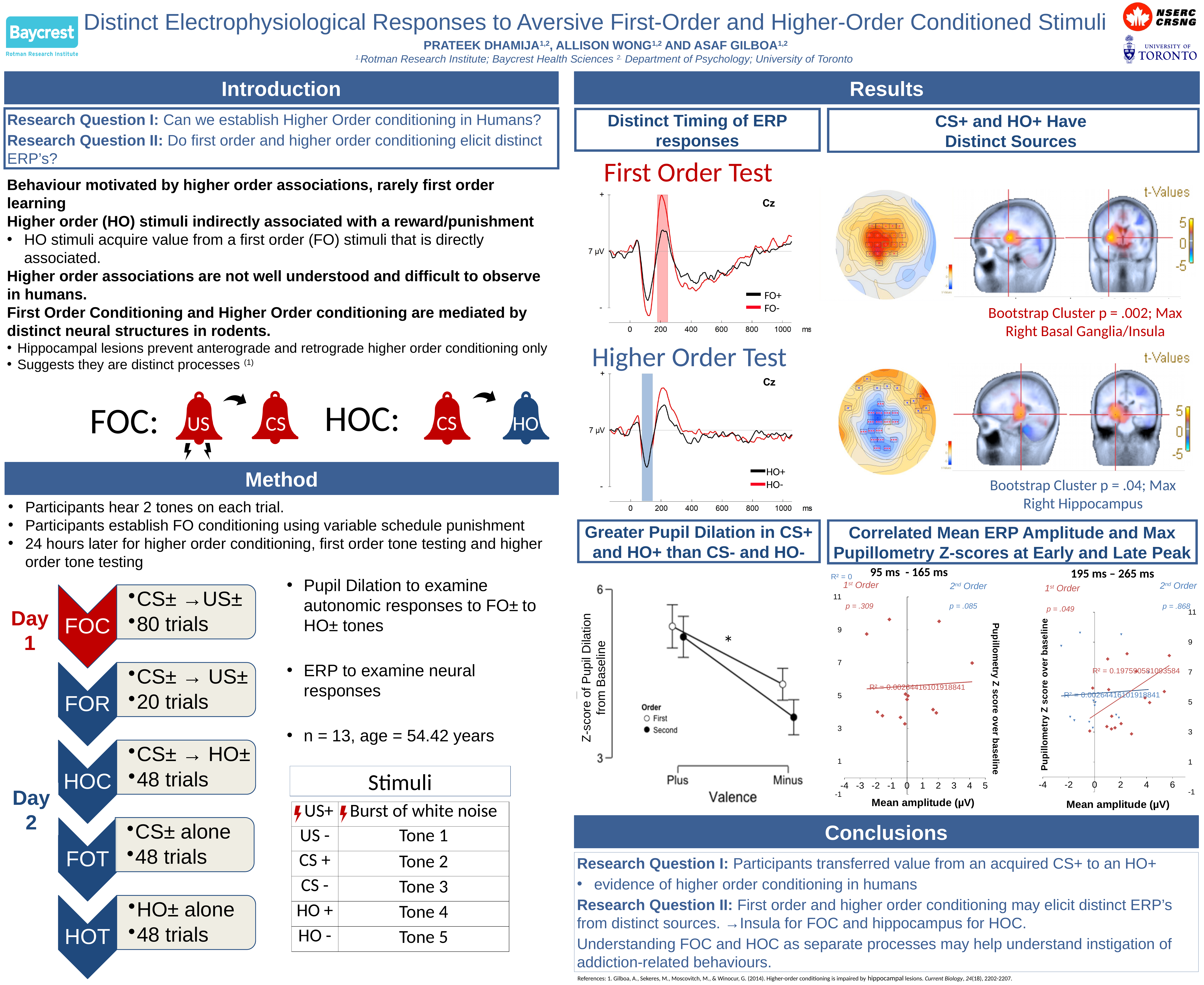
How many series does the legend of the First Order Test chart list? 2 What kind of chart is the First Order Test chart? line chart In the 95 ms - 165 ms scatter plot, what is the p value shown for 1st Order? p = .309 What are the two legend entries on the Higher Order Test chart? HO+ and HO- In the 195 ms – 265 ms scatter plot, what is the p value shown for 2nd Order? p = .868 On the pupil dilation chart, is the Second order value at Minus greater or less than 5? less What is the x-axis label of the 195 ms – 265 ms scatter plot? Mean amplitude (µV) On the pupil dilation chart, how many series does the Order legend list? 2 On the pupil dilation chart, is the First order value at Plus greater or less than 5? greater On the pupil dilation chart, do the values rise or fall from Plus to Minus? fall On the pupil dilation chart (Z-score of Pupil Dilation from Baseline), how many valence categories are shown on the x axis? 2 On the pupil dilation chart, which valence has the larger Z-score for the Second order series, Plus or Minus? Plus